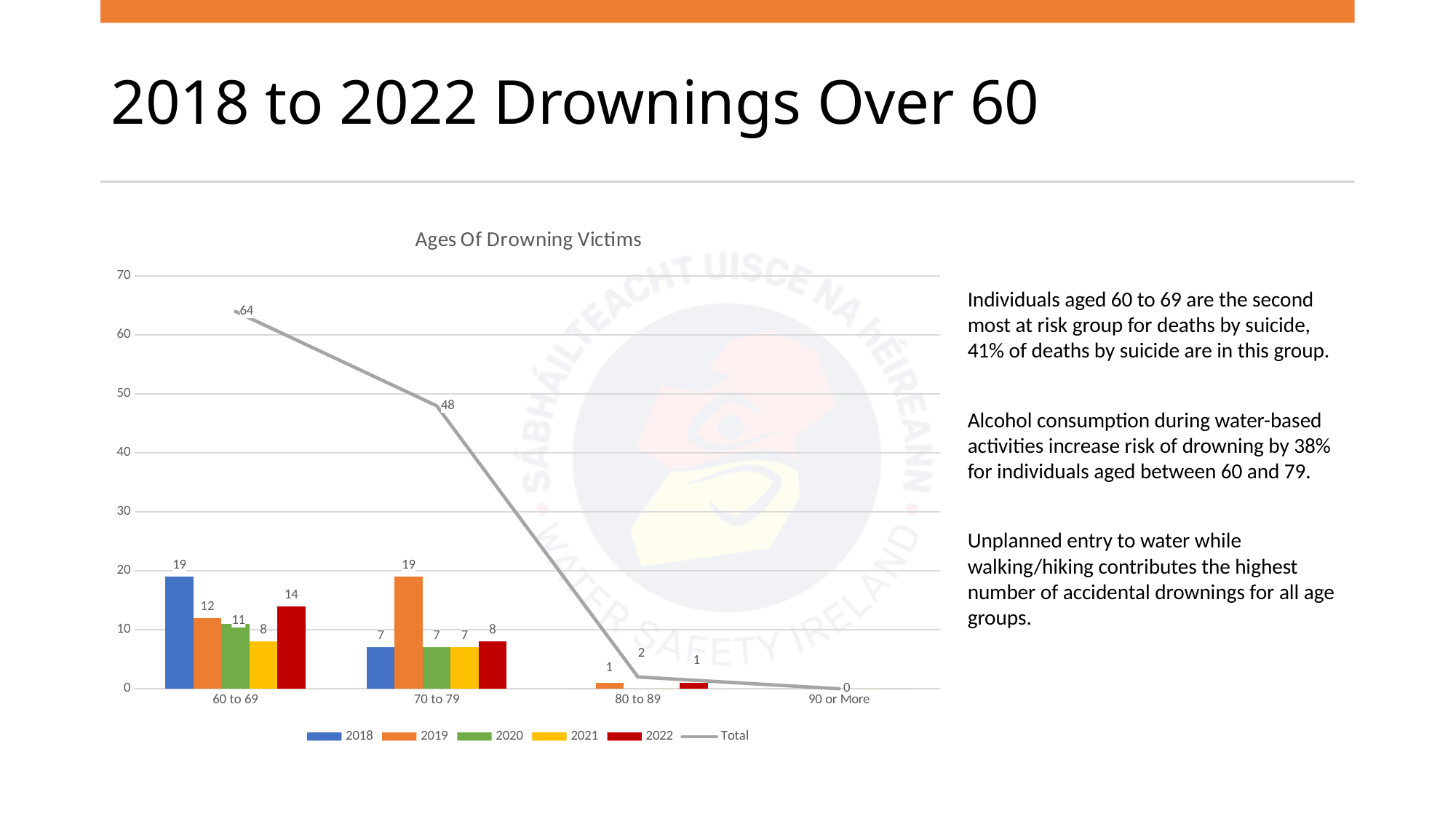
Which age group has the highest Total value? 60 to 69 What is the Total value for the 80 to 89 age group? 2 How many age group categories are shown on the x axis? 4 What is the title of the chart? Ages Of Drowning Victims What is the Total value for the 60 to 69 age group? 64 How many series does the legend list? 6 Does the Total line rise or fall from 60 to 69 to 90 or More? Falls What is the 2019 value for the 70 to 79 age group? 19 Which age group has the lowest Total value? 90 or More What is the 2022 value for the 60 to 69 age group? 14 Which is larger for the 60 to 69 age group, the 2018 value or the 2019 value? 2018 What is the difference between the Total values for 60 to 69 and 70 to 79? 16